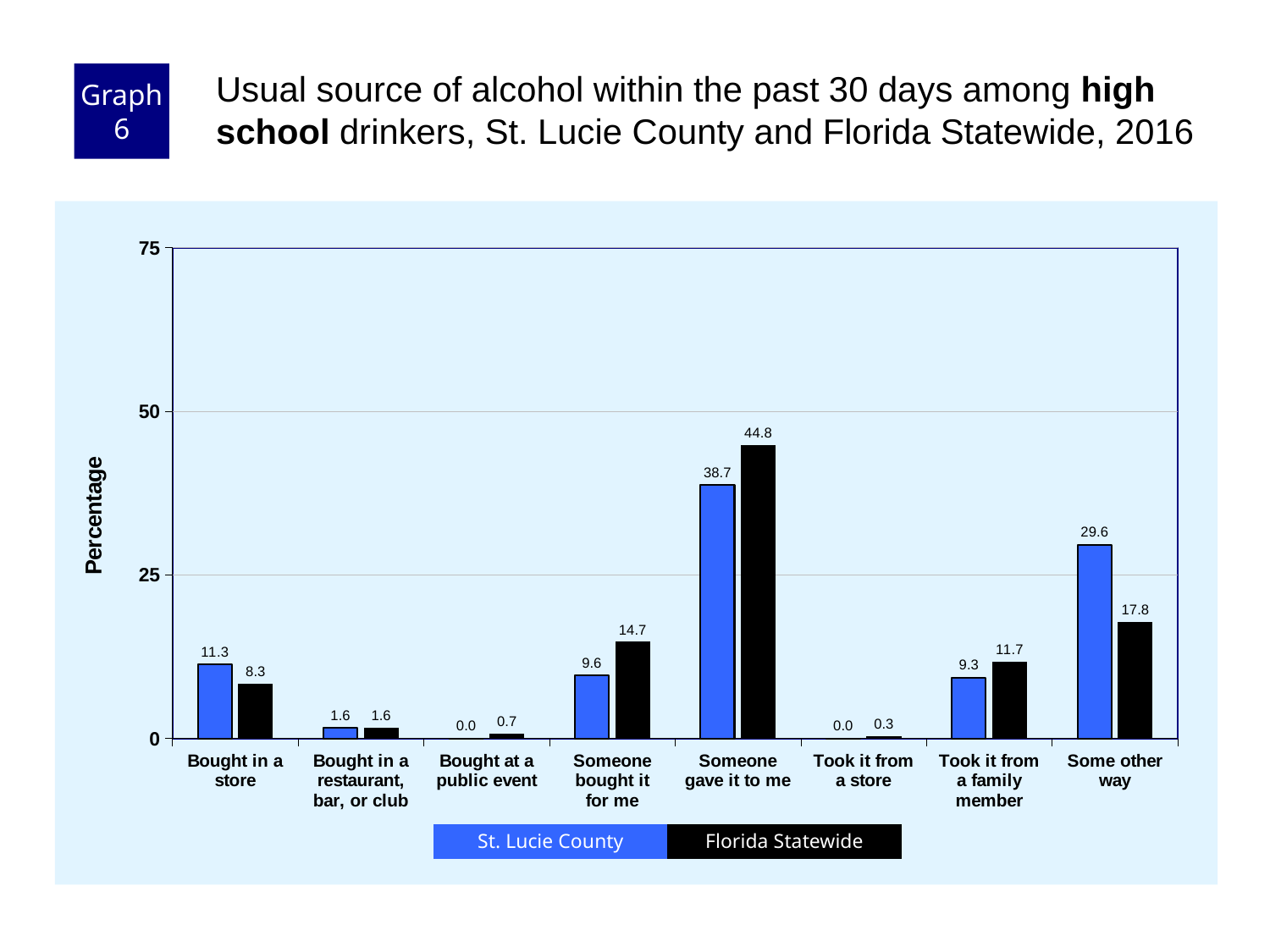
Which category has the highest Florida Statewide value? Someone gave it to me How many categories are shown on the x axis? 8 What kind of chart is shown on the slide? bar chart What is the Florida Statewide value for "Bought at a public event"? 0.7 What is the difference between the Florida Statewide and St. Lucie County values for "Someone gave it to me"? 6.1 Which category has the lowest St. Lucie County value? Bought at a public event and Took it from a store (both 0.0) What is the Florida Statewide value for "Some other way"? 17.8 Is the Florida Statewide value for "Someone gave it to me" greater or less than 50? less For "Bought in a store", which is larger: St. Lucie County or Florida Statewide? St. Lucie County What is the St. Lucie County value for "Someone gave it to me"? 38.7 How many series does the legend list? 2 What is the difference between the St. Lucie County and Florida Statewide values for "Some other way"? 11.8